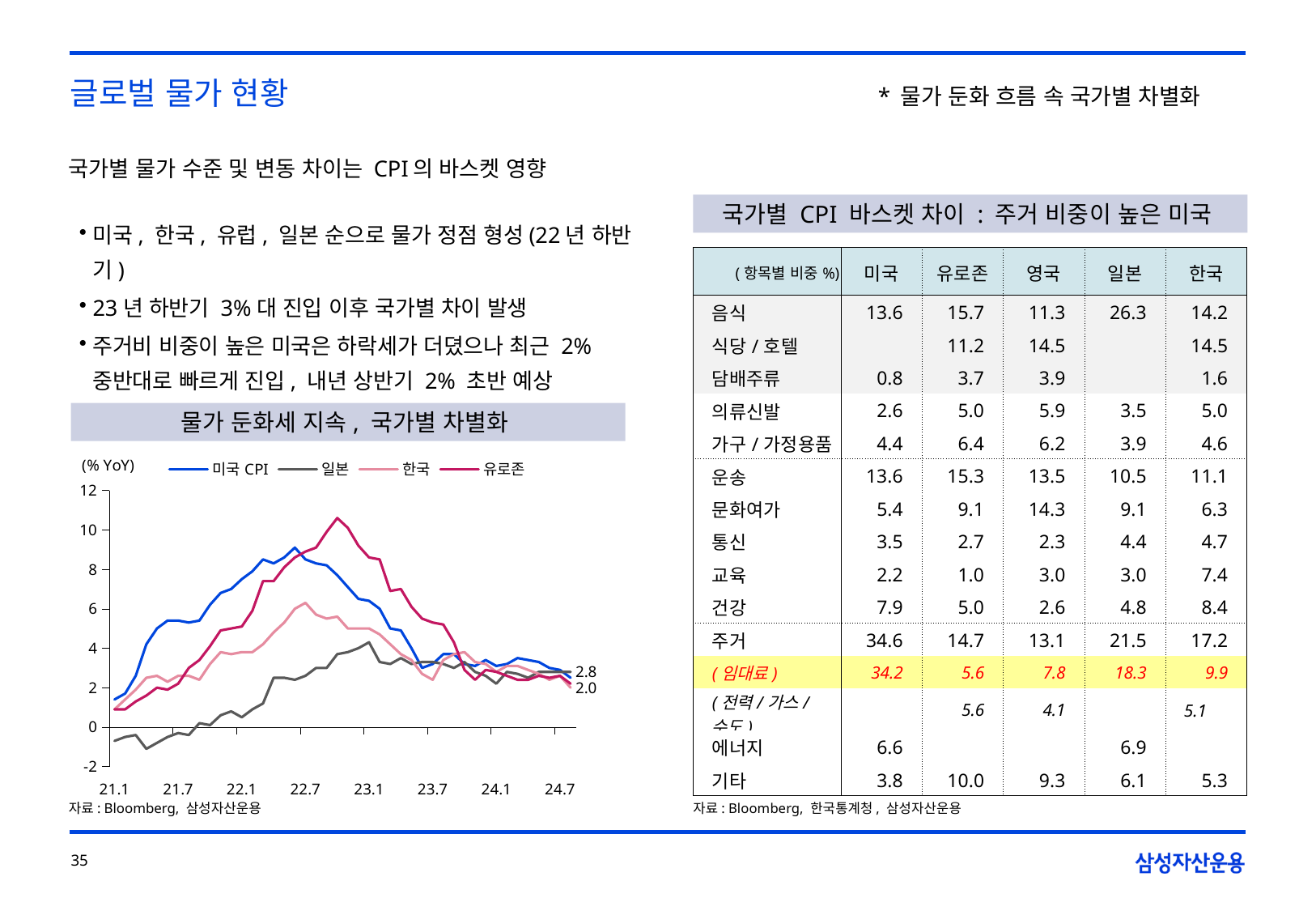
What unit is shown on the y axis of the line chart? % YoY Is the peak value of the 일본 series greater or less than 6? less Which series reaches the highest peak in the line chart? 유로존 Which series is the only one that dips below 0 at the start of the line chart? 일본 Which series are listed in the legend of the line chart? 미국 CPI, 일본, 한국, 유로존 At 23.1, which series is higher: 유로존 or 일본? 유로존 Is the peak value of the 미국 CPI series greater or less than 8? greater How many series does the legend of the line chart list? 4 Does the 미국 CPI series rise or fall between 22.7 and 24.7? fall Is the peak value of the 유로존 series greater or less than 10? greater What kind of chart is shown under the heading '물가 둔화세 지속, 국가별 차별화'? line chart What two values are labelled at the right end of the lines in the line chart? 2.8 and 2.0